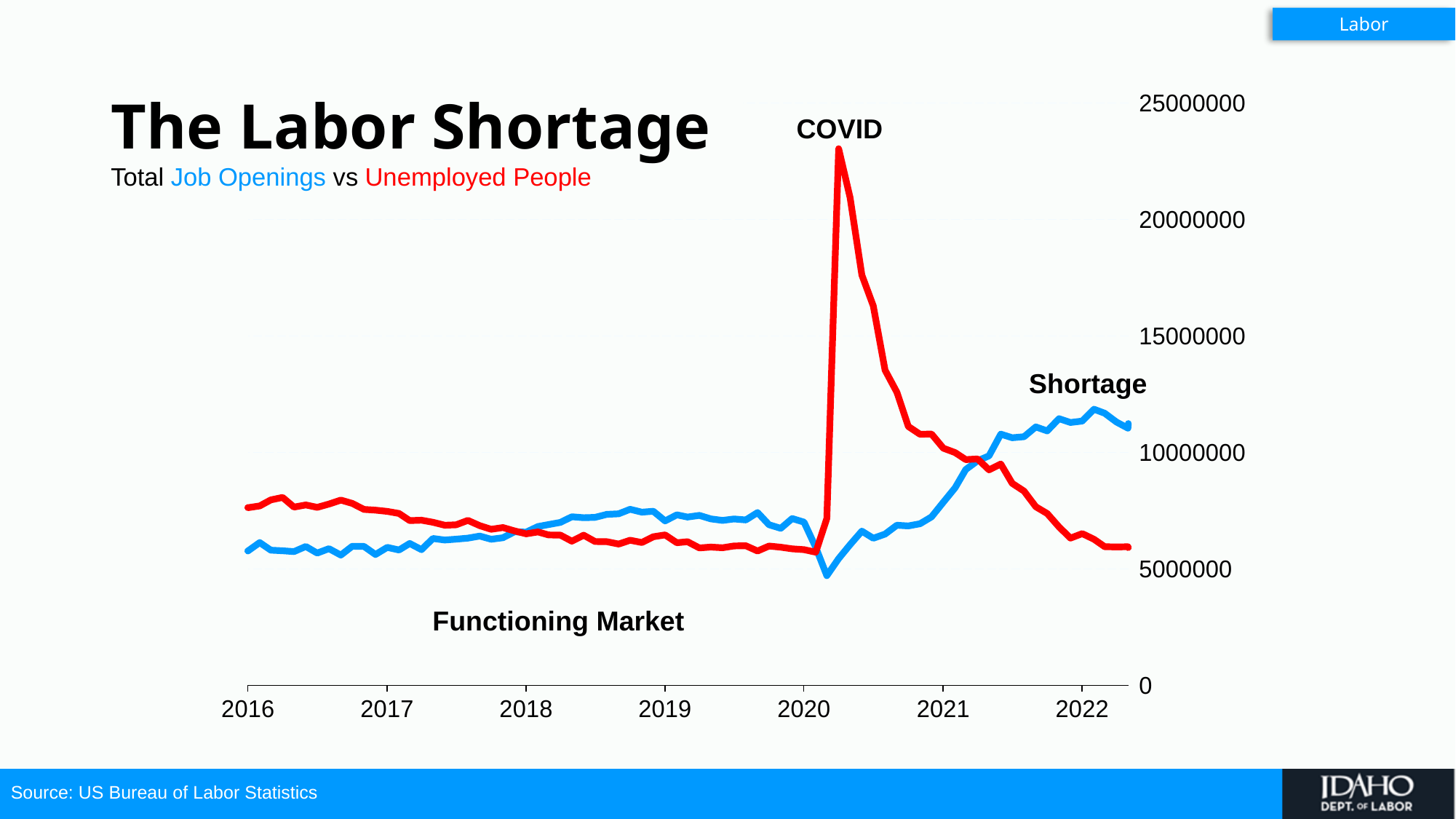
Which series reaches the highest value anywhere on the chart? Unemployed People At the start of 2016, which is higher: Job Openings or Unemployed People? Unemployed People Does the Unemployed People line rise or fall from 2021 to 2022? fall Is the peak value of Unemployed People in 2020 greater or less than 20000000? greater Which two series does the chart compare, according to the subtitle? Job Openings and Unemployed People How many data series are plotted on the chart? 2 In 2022, which is higher: Job Openings or Unemployed People? Job Openings Is the value for Job Openings in early 2022 greater or less than 10000000? greater What type of chart is shown on the slide? line chart How many year labels are shown on the x axis? 7 Is the value for Job Openings at the start of 2016 greater or less than 10000000? less